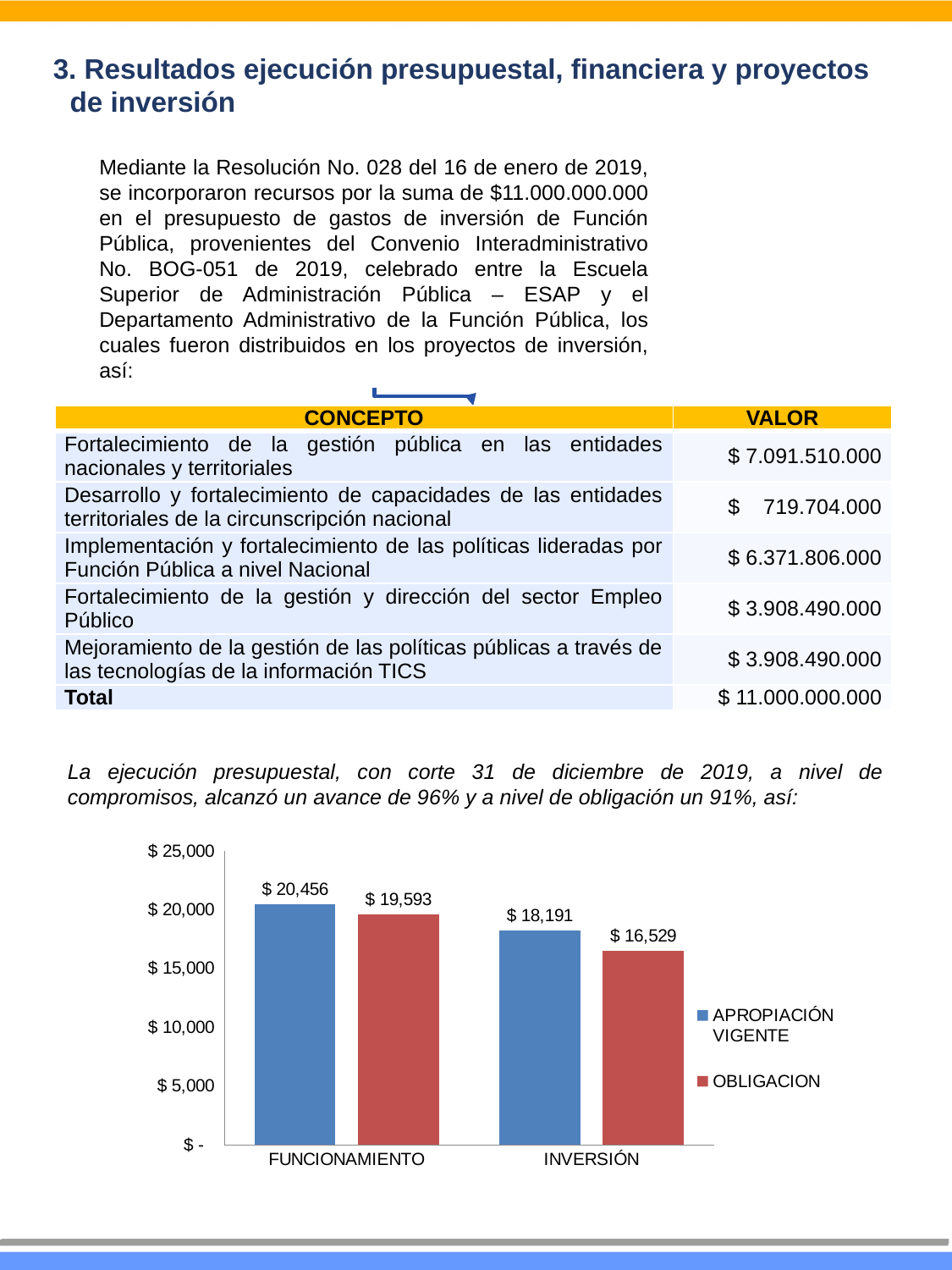
What is the APROPIACIÓN VIGENTE value for INVERSIÓN? $ 18,191 What type of chart is shown on the slide? Bar chart How many categories are shown on the x axis of the chart? 2 Which category has the highest APROPIACIÓN VIGENTE value? FUNCIONAMIENTO Which category has the lowest OBLIGACION value? INVERSIÓN What is the OBLIGACION value for FUNCIONAMIENTO? $ 19,593 How many series does the chart legend list? 2 What is the difference between APROPIACIÓN VIGENTE and OBLIGACION for INVERSIÓN? $ 1,662 What is the OBLIGACION value for INVERSIÓN? $ 16,529 What is the APROPIACIÓN VIGENTE value for FUNCIONAMIENTO? $ 20,456 What is the difference between the APROPIACIÓN VIGENTE values for FUNCIONAMIENTO and INVERSIÓN? $ 2,265 Which is larger: the OBLIGACION value for FUNCIONAMIENTO or the APROPIACIÓN VIGENTE value for INVERSIÓN? OBLIGACION for FUNCIONAMIENTO